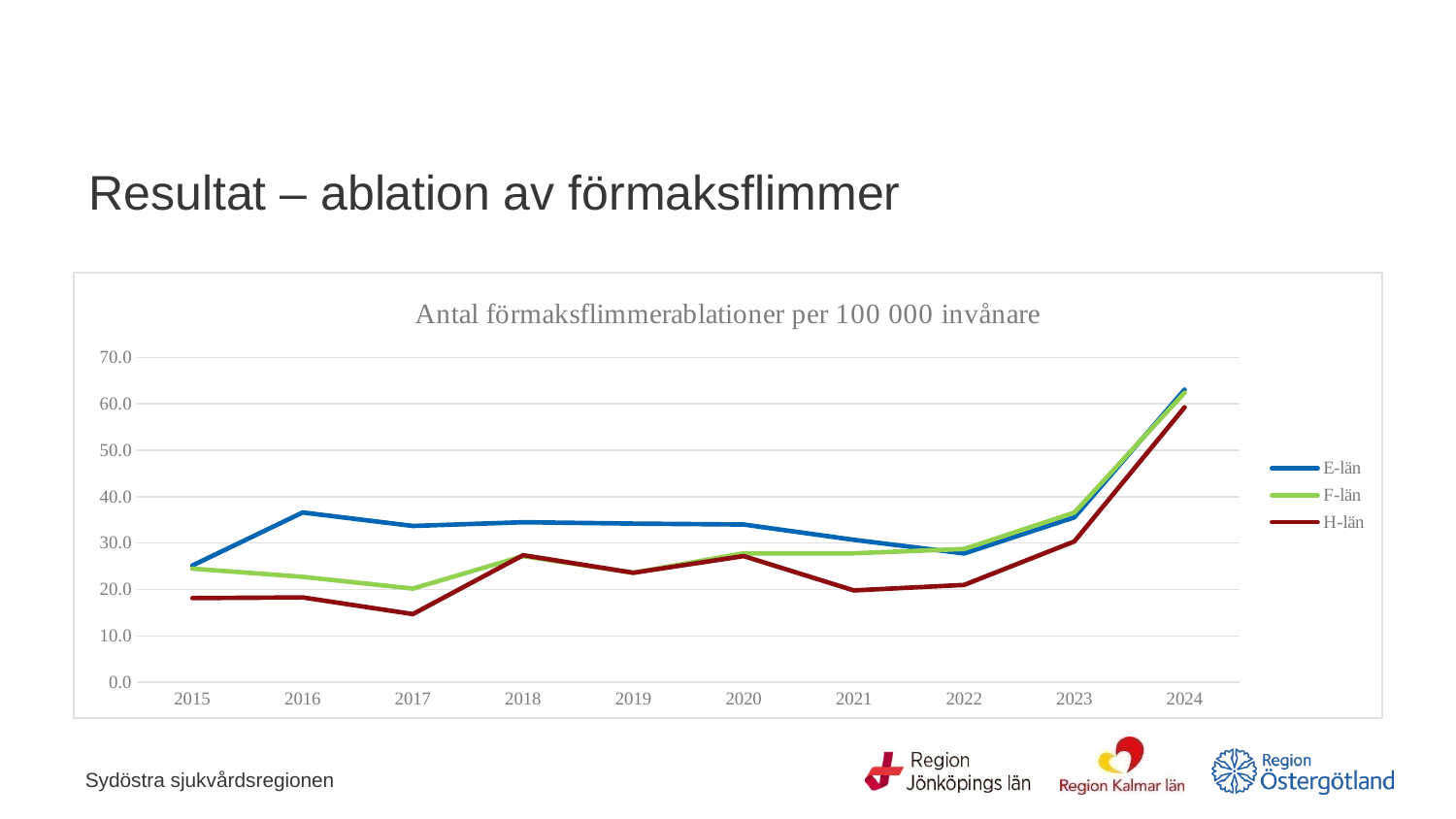
What is the title of the chart? Antal förmaksflimmerablationer per 100 000 invånare Is the value for H-län in 2024 greater or less than 50.0? greater Which series is drawn in dark red? H-län How many series does the legend list? 3 Is the value for E-län in 2016 greater or less than 30.0? greater Is the value for H-län in 2017 greater or less than 20.0? less In 2016, which is larger, the value for E-län or the value for H-län? E-län Do the values for H-län rise or fall from 2022 to 2024? rise How many years are shown on the x axis? 10 In which year does H-län have its lowest value? 2017 What kind of chart is shown on the slide? Line chart In which year does H-län reach its highest value? 2024